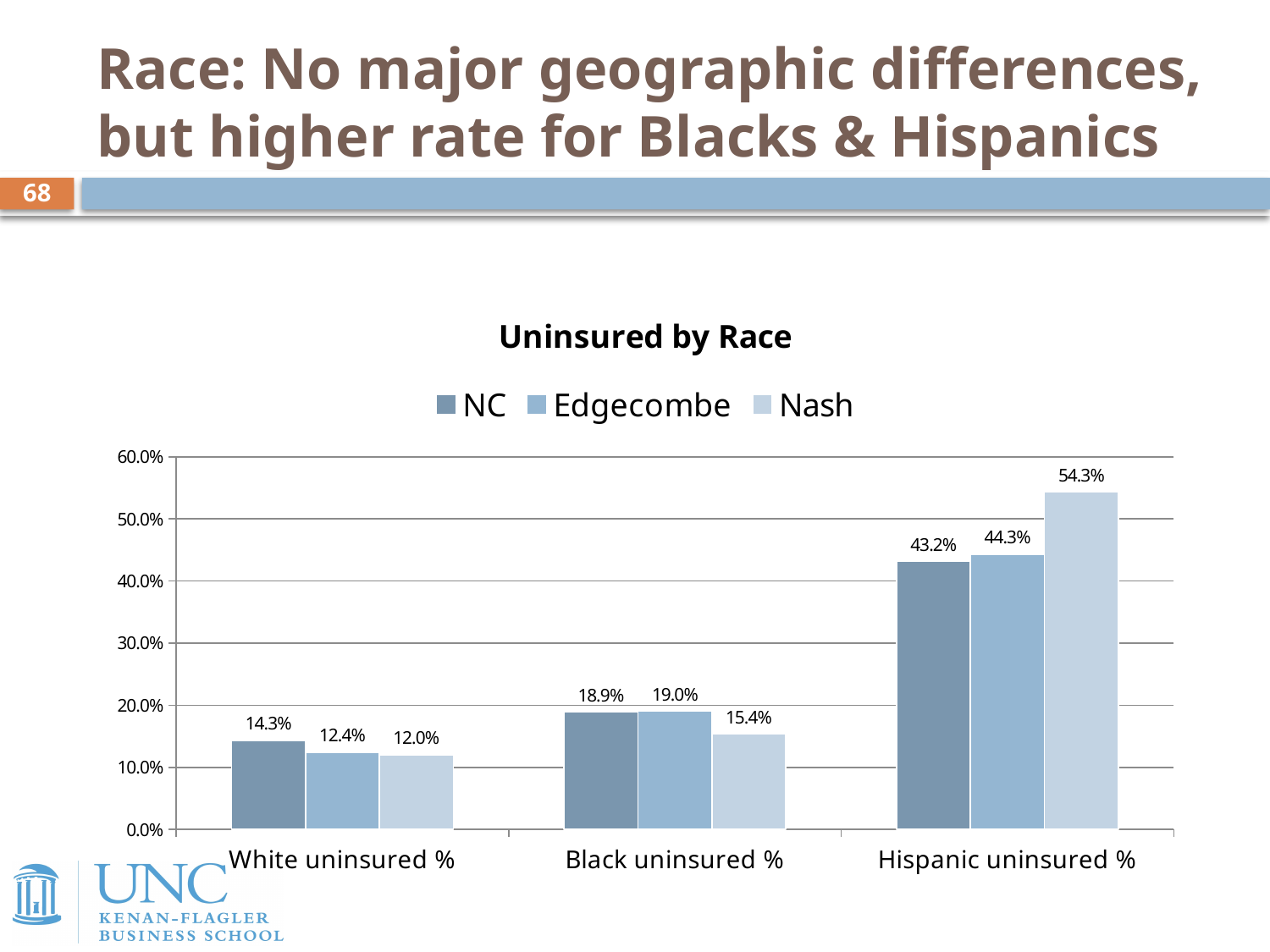
What kind of chart is shown? bar chart Which is larger for Black uninsured %: the NC value or the Nash value? NC What is the Nash value for Hispanic uninsured %? 54.3% Which category has the highest Nash value? Hispanic uninsured % What is the NC value for White uninsured %? 14.3% What is the title of the chart? Uninsured by Race How many categories are shown on the x axis? 3 How many series does the legend list? 3 What is the difference between the Nash and NC values for Hispanic uninsured %? 11.1% What is the Edgecombe value for Black uninsured %? 19.0% Which category has the lowest NC value? White uninsured % Is the Edgecombe value for Hispanic uninsured % greater or less than 40.0%? greater